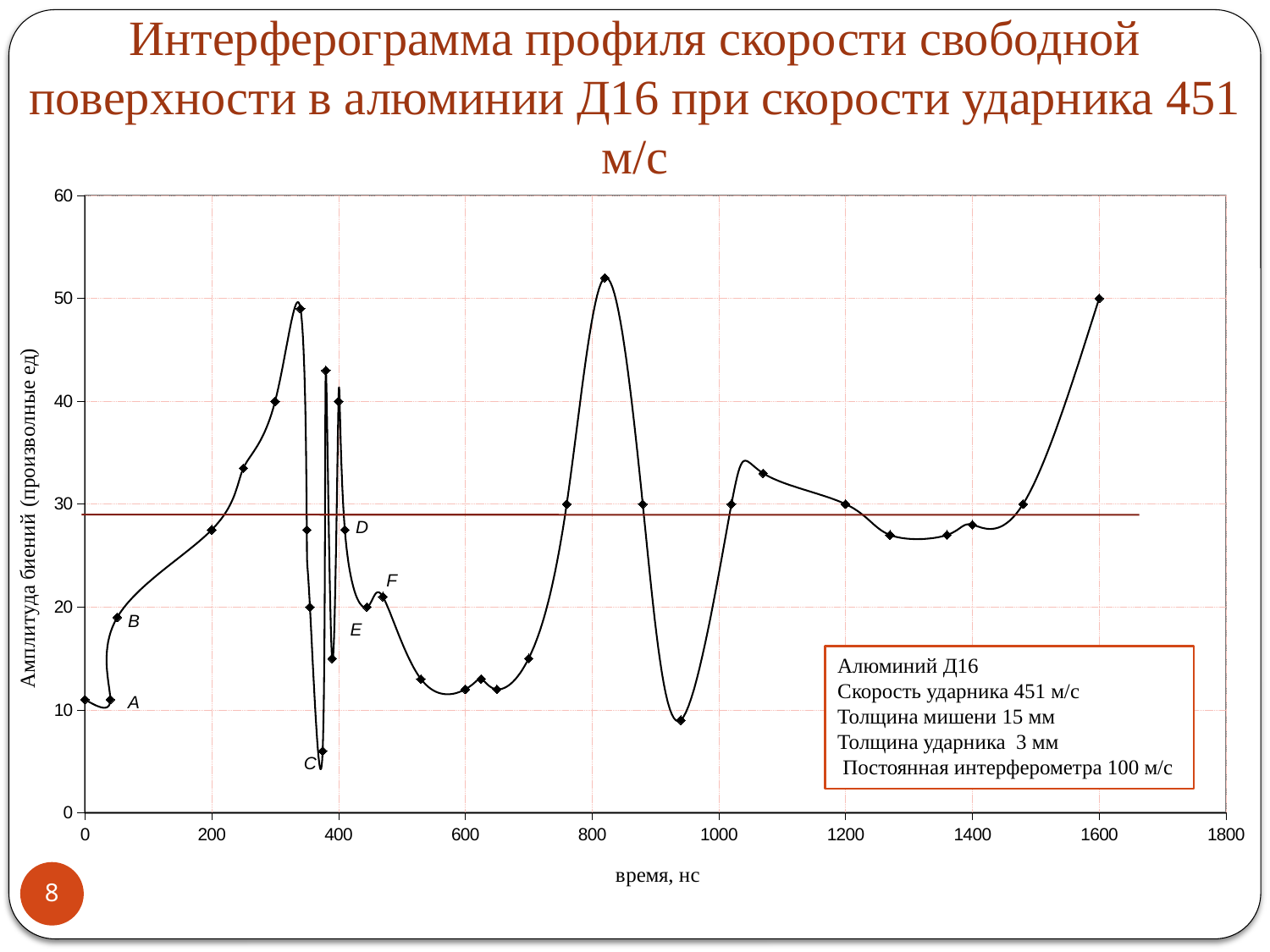
Is the peak value of the curve near 800 ns greater or less than 50? greater Is the value at point C greater or less than 10? less Is the value at point F greater or less than 30? less Which of the labelled points A to F has the lowest value? C Which of the labelled points A to F has the highest value? D What kind of chart is shown on the slide? line chart What is the title of the y axis of the chart? Амплитуда биений (произволные ед) How many points on the curve are labelled with letters (A to F)? 6 What is the title of the x axis of the chart? время, нс Which has the larger value, point D or point F? D